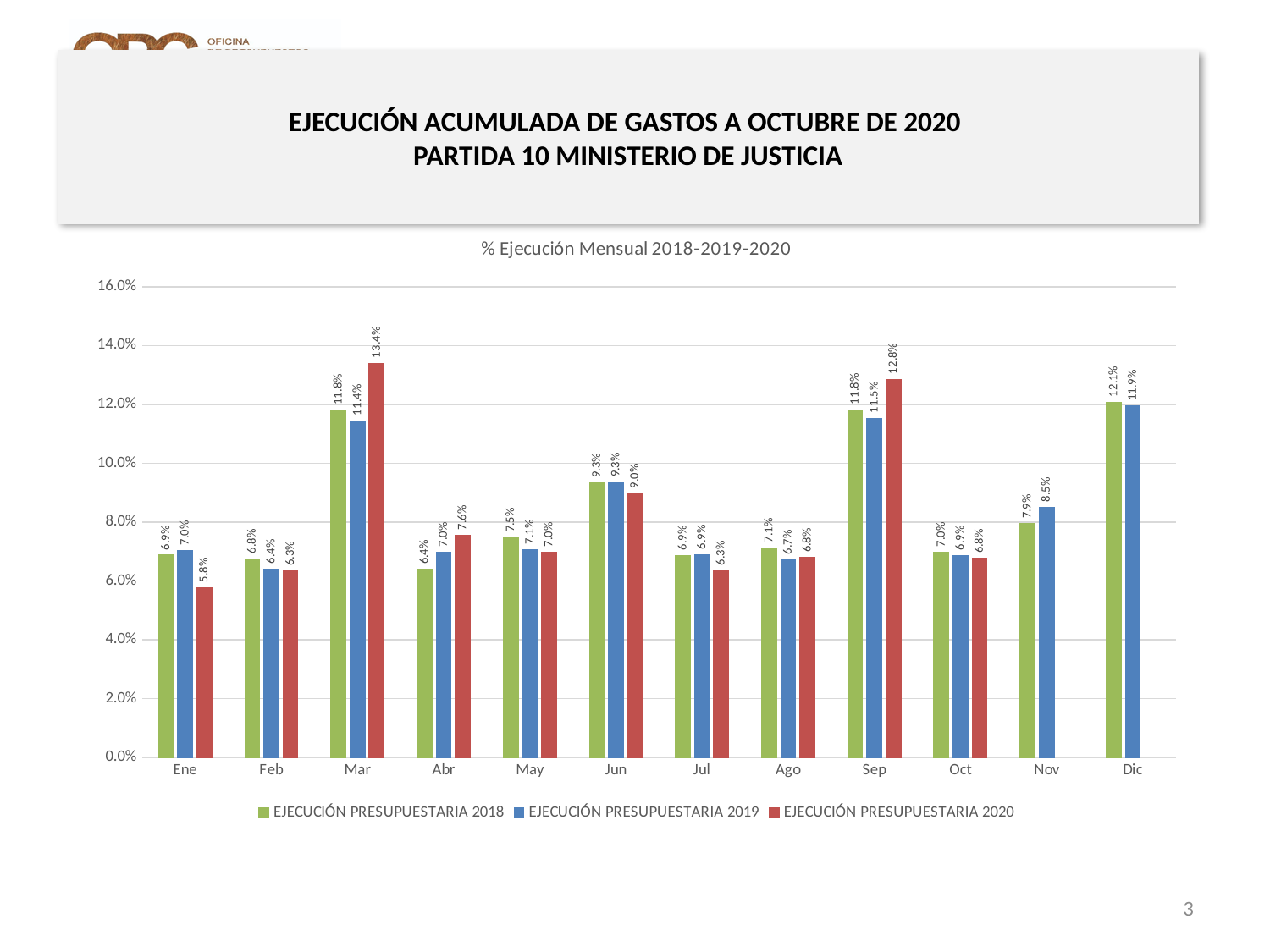
What is the value for EJECUCIÓN PRESUPUESTARIA 2020 in Mar? 13.4% Which is larger in Abr: EJECUCIÓN PRESUPUESTARIA 2018 or EJECUCIÓN PRESUPUESTARIA 2020? EJECUCIÓN PRESUPUESTARIA 2020 What is the title of the chart? % Ejecución Mensual 2018-2019-2020 What is the value for EJECUCIÓN PRESUPUESTARIA 2020 in Ene? 5.8% In which month does EJECUCIÓN PRESUPUESTARIA 2020 reach its highest value? Mar In which month is EJECUCIÓN PRESUPUESTARIA 2018 lowest? Abr How many months are shown on the x axis? 12 What is the difference between the 2020 and 2018 values in Sep? 1.0% What is the value for EJECUCIÓN PRESUPUESTARIA 2018 in Dic? 12.1% How many series does the legend list? 3 What is the value for EJECUCIÓN PRESUPUESTARIA 2019 in Nov? 8.5% What kind of chart is shown on the slide? Bar chart